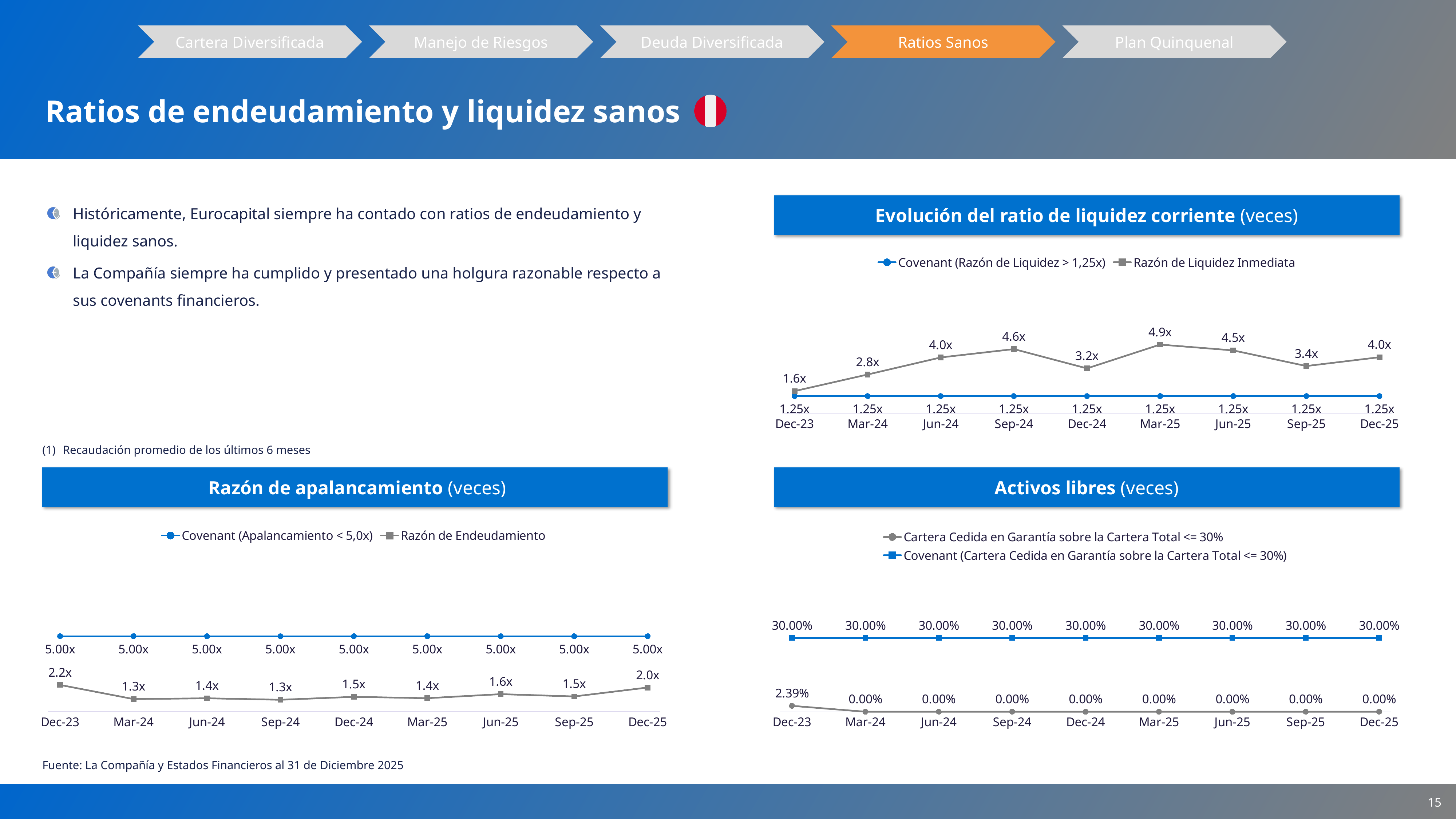
In the 'Razón de apalancamiento' chart, how many periods are shown on the x axis? 9 In the 'Activos libres' chart, what is the Covenant value shown for Jun-24? 30.00% What type of chart is the 'Activos libres' chart? Line chart In the 'Razón de apalancamiento' chart, what is the Razón de Endeudamiento value for Dec-25? 2.0x In the 'Activos libres' chart, what is the Cartera Cedida en Garantía sobre la Cartera Total value for Dec-23? 2.39% In the 'Evolución del ratio de liquidez corriente' chart, what is the difference between the Razón de Liquidez Inmediata at Sep-24 and at Dec-24? 1.4x In the 'Evolución del ratio de liquidez corriente' chart, which period has the highest Razón de Liquidez Inmediata? Mar-25 In the 'Evolución del ratio de liquidez corriente' chart, what is the Covenant value shown for every period? 1.25x In the 'Razón de apalancamiento' chart, which period has the highest Razón de Endeudamiento? Dec-23 In the 'Razón de apalancamiento' chart, is the Razón de Endeudamiento larger at Jun-25 or at Mar-25? Jun-25 In the 'Evolución del ratio de liquidez corriente' chart, what is the Razón de Liquidez Inmediata value for Mar-25? 4.9x In the 'Evolución del ratio de liquidez corriente' chart, which period has the lowest Razón de Liquidez Inmediata? Dec-23